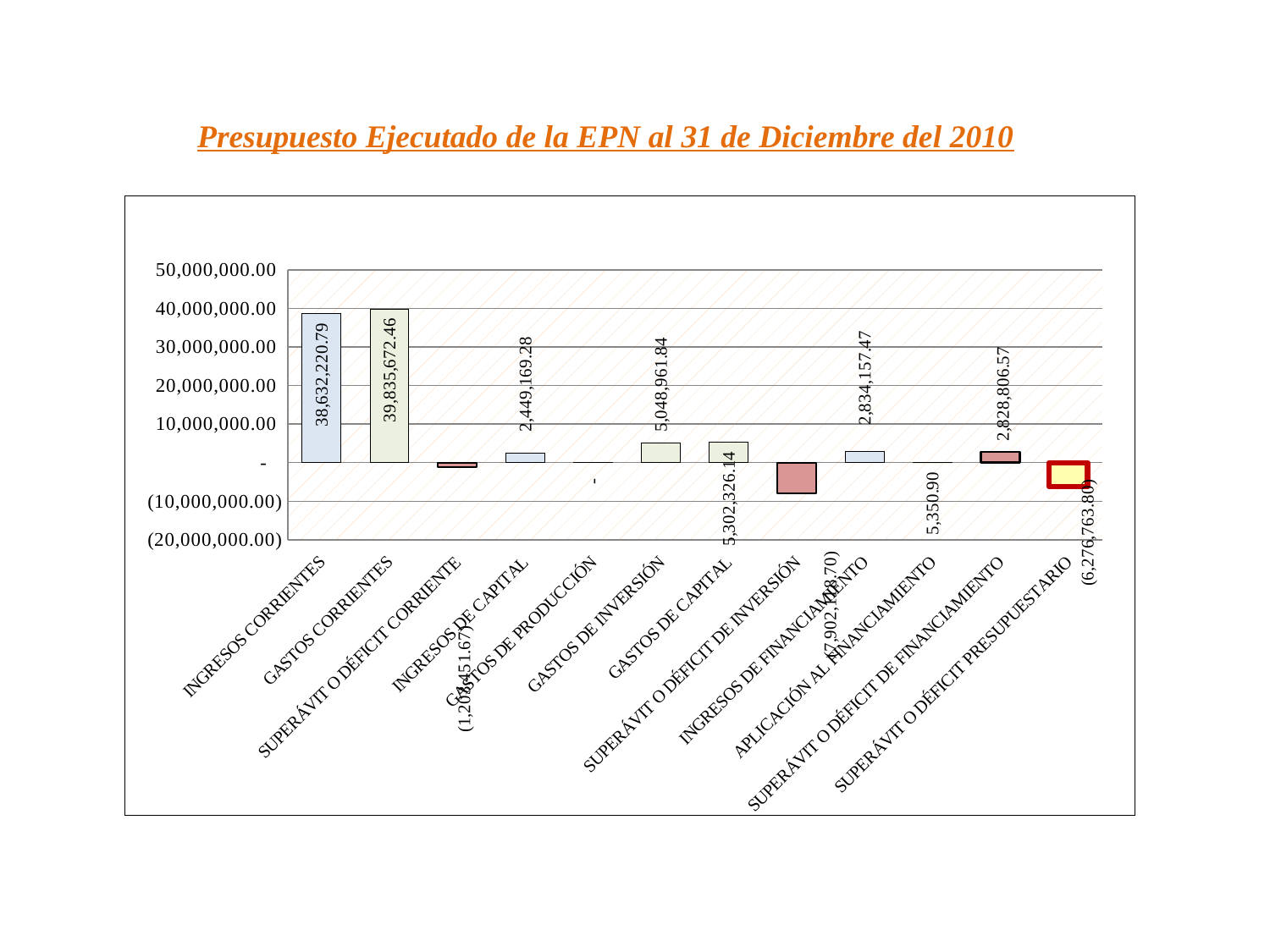
What is the value for APLICACIÓN AL FINANCIAMIENTO? 5,350.90 What is the difference between GASTOS DE CAPITAL and GASTOS DE INVERSIÓN? 253,364.30 What is the difference between GASTOS CORRIENTES and INGRESOS CORRIENTES? 1,203,451.67 What is the value for GASTOS CORRIENTES? 39,835,672.46 Is the value for GASTOS DE INVERSIÓN greater or less than 10,000,000.00? less Which is larger, INGRESOS CORRIENTES or GASTOS CORRIENTES? GASTOS CORRIENTES What is the value for INGRESOS DE CAPITAL? 2,449,169.28 What type of chart is shown on the slide? bar chart What is the value for INGRESOS CORRIENTES? 38,632,220.79 Which category has the highest value? GASTOS CORRIENTES How many categories are shown on the x axis? 12 What is the value for GASTOS DE INVERSIÓN? 5,048,961.84